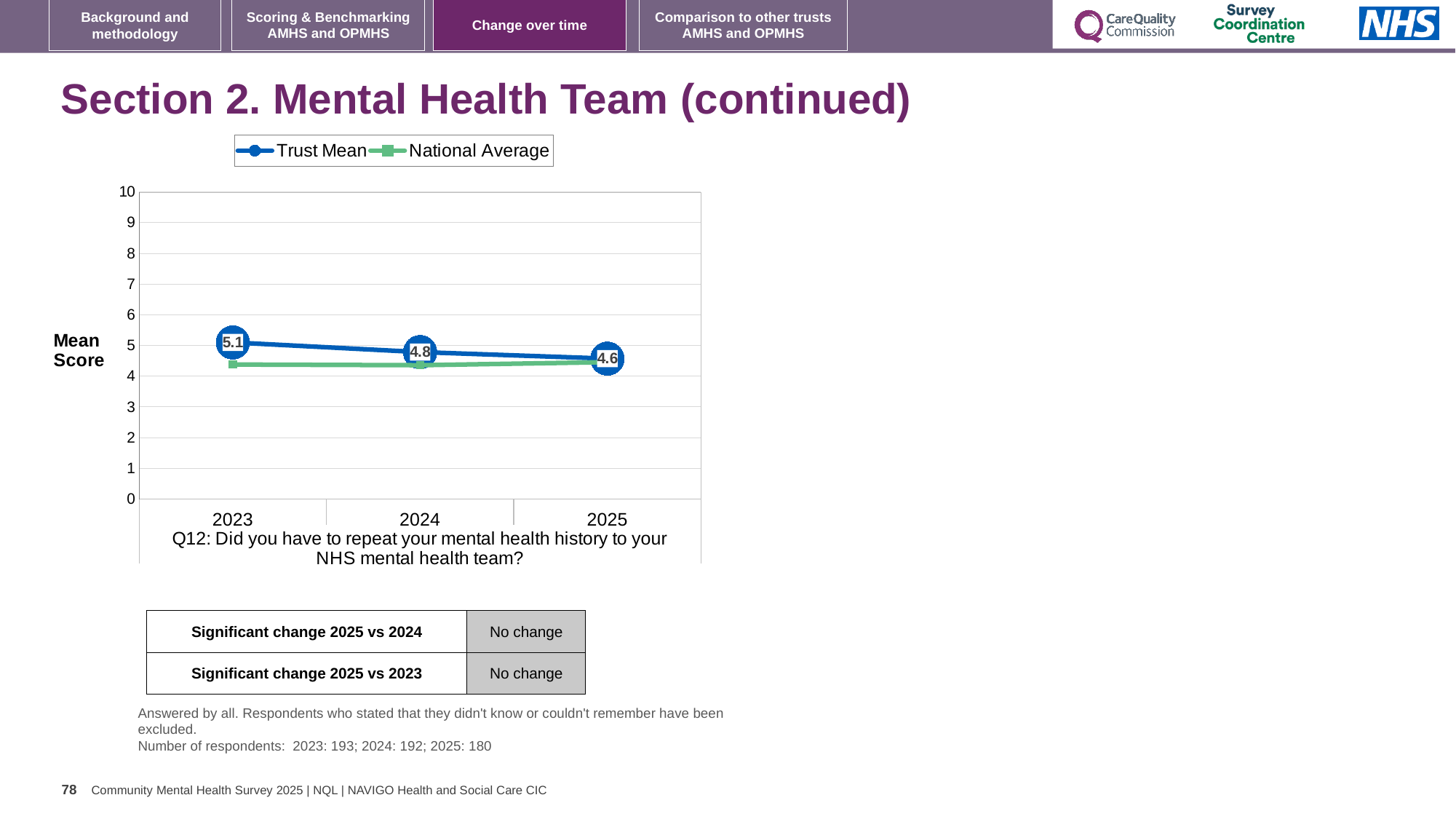
What is the Trust Mean score for 2023? 5.1 What is the difference between the Trust Mean in 2023 and in 2025? 0.5 In which year is the Trust Mean highest? 2023 Does the Trust Mean rise or fall from 2023 to 2025? fall Is the National Average value for 2023 greater or less than 5? less What is the Trust Mean score for 2025? 4.6 What is the Trust Mean score for 2024? 4.8 Which is larger, the Trust Mean in 2023 or in 2025? 2023 What kind of chart is shown on the slide? line chart In which year is the Trust Mean lowest? 2025 How many years are shown on the x axis? 3 How many series does the legend list? 2